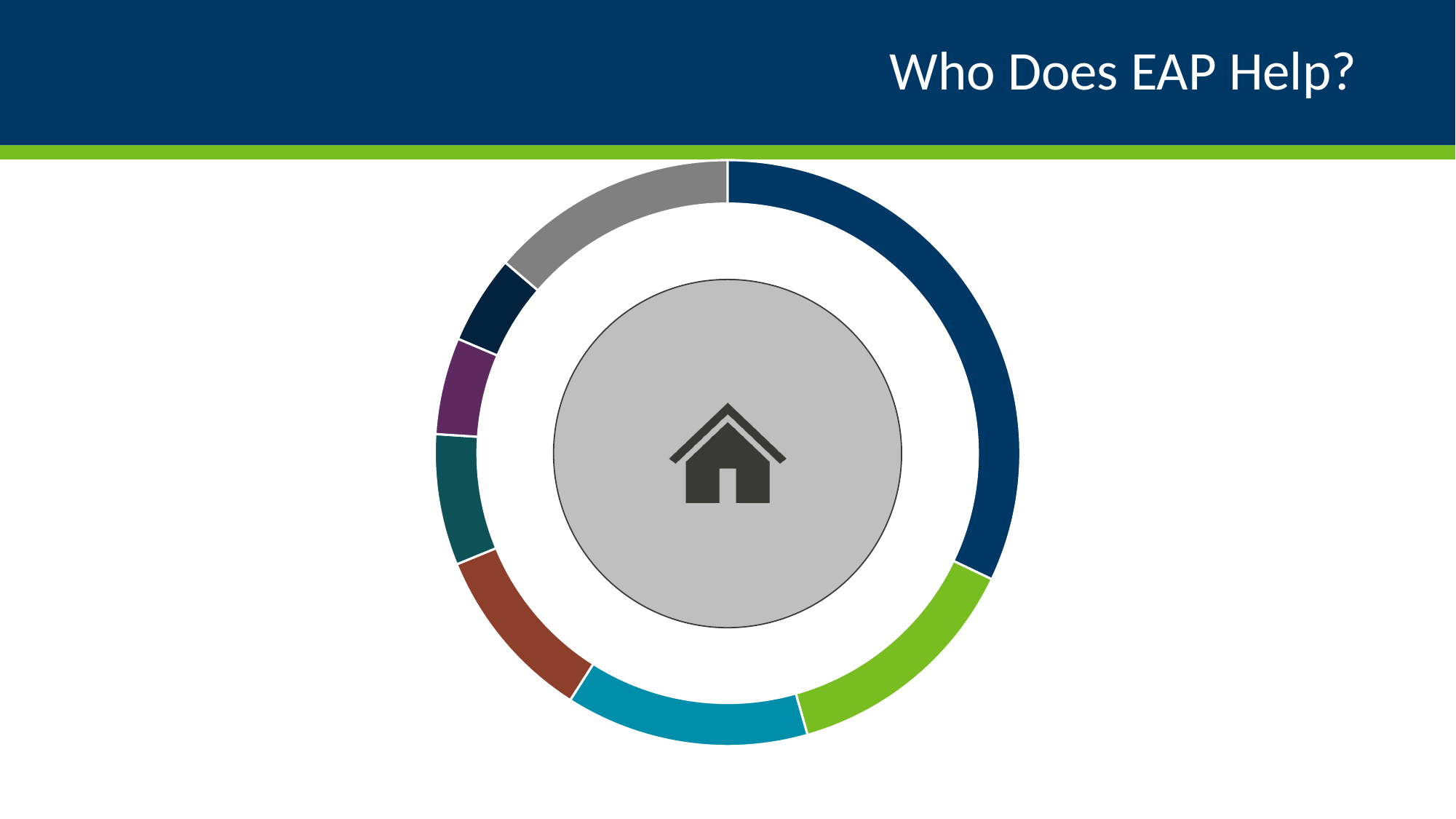
How many segments does the doughnut chart have? 8 What kind of chart is shown on the slide? Doughnut chart Which is larger in the doughnut chart, the dark blue segment or the purple segment? Dark blue What is the title of the slide containing the doughnut chart? Who Does EAP Help? Which colour segment of the doughnut chart is the largest? Dark blue What icon is shown in the centre of the doughnut chart? A house Which is larger in the doughnut chart, the green segment or the dark navy segment? Green